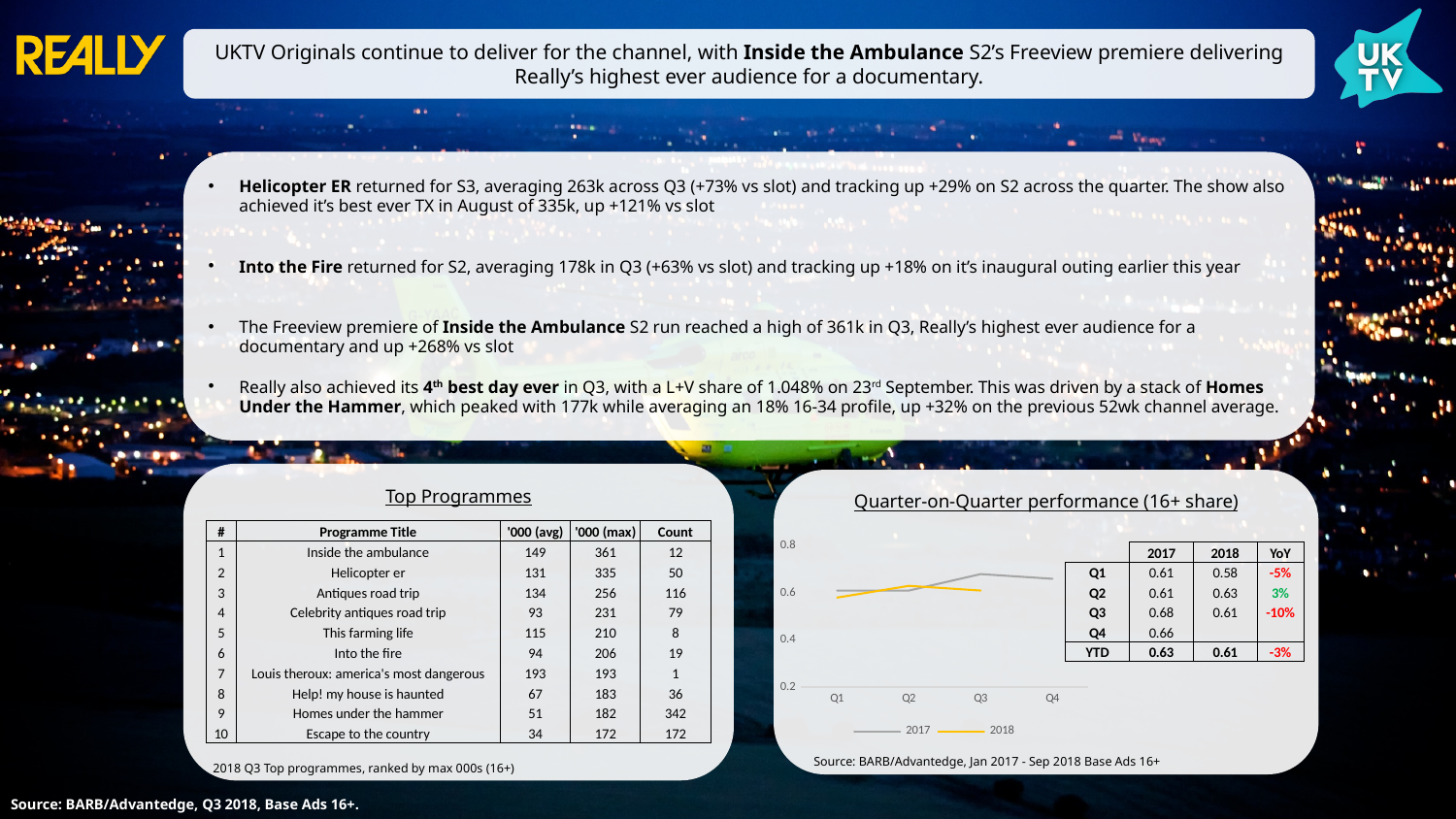
What are the legend entries on the Quarter-on-Quarter performance chart? 2017 and 2018 According to the table beside the Quarter-on-Quarter performance chart, what is the 2018 share for Q2? 0.63 On the Quarter-on-Quarter performance chart, is the 2018 value for Q1 greater or less than 0.6? less According to the table beside the Quarter-on-Quarter performance chart, what is the 2017 share for Q3? 0.68 Using the table beside the Quarter-on-Quarter performance chart, what is the difference between the 2017 and 2018 shares for Q3? 0.07 On the Quarter-on-Quarter performance chart, does the 2017 series rise or fall from Q2 to Q3? rise How many series does the legend of the Quarter-on-Quarter performance chart list? 2 On the Quarter-on-Quarter performance chart, which series has the larger value in Q2, 2017 or 2018? 2018 In which quarter does the 2017 series reach its highest value on the Quarter-on-Quarter performance chart? Q3 On the Quarter-on-Quarter performance chart, is the 2017 value for Q3 greater or less than 0.6? greater How many quarters are shown on the x axis of the Quarter-on-Quarter performance chart? 4 What kind of chart is the Quarter-on-Quarter performance (16+ share) chart? line chart